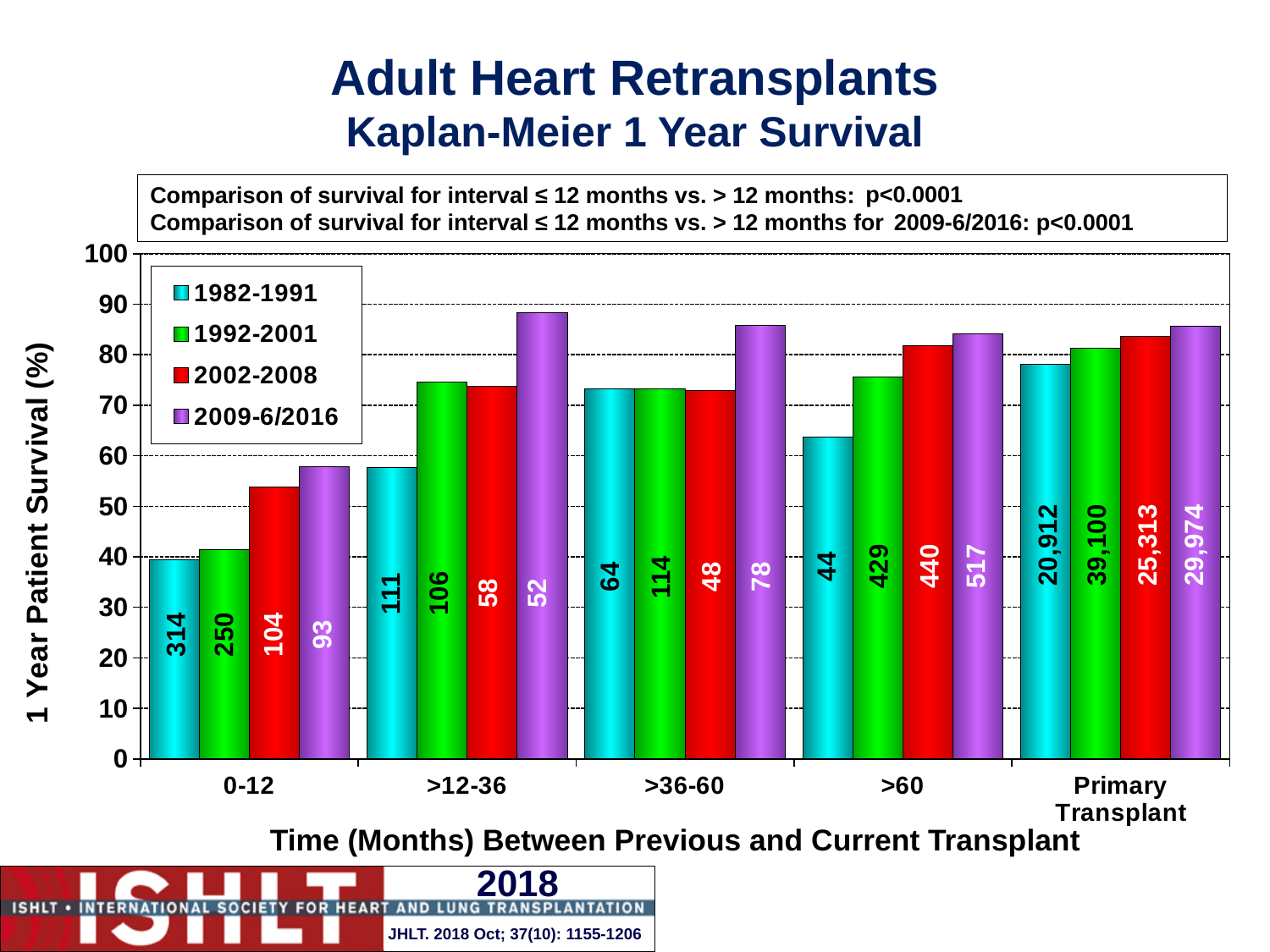
In the 0-12 months group, do the survival values rise or fall from the 1982-1991 era to the 2009-6/2016 era? rise In the 0-12 months group, which era has higher 1 year survival: 2002-2008 or 2009-6/2016? 2009-6/2016 Which era has the lowest 1 year survival in the 0-12 months group? 1982-1991 What is the title of the y axis? 1 Year Patient Survival (%) How many categories are shown along the x axis? 5 What kind of chart is shown on the slide? bar chart In the >12-36 months group, is the 1 year survival for 2009-6/2016 greater or less than 80? greater In the >60 months group, is the 1 year survival for 1982-1991 greater or less than 60? greater What number is printed inside the 2009-6/2016 bar for Primary Transplant? 29,974 How many series does the legend list? 4 Which era has the highest 1 year survival in the 0-12 months group? 2009-6/2016 In the 0-12 months group, is the 1 year survival for 2009-6/2016 greater or less than 60? less